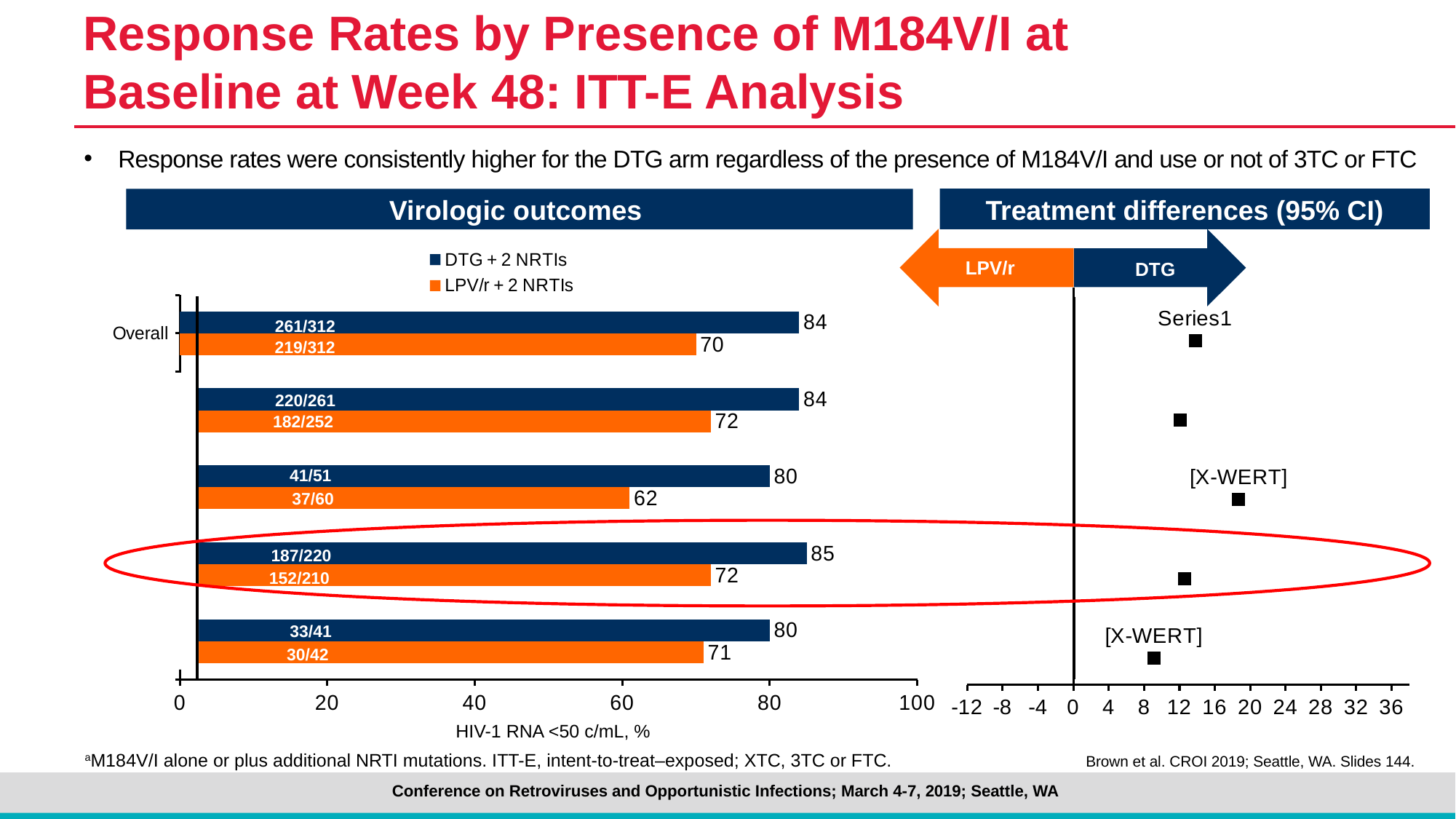
What is the x-axis label of the Virologic outcomes chart? HIV-1 RNA <50 c/mL, % In the Virologic outcomes chart, what is the highest value shown for the DTG + 2 NRTIs series? 85 In the Virologic outcomes chart, what fraction is printed on the DTG + 2 NRTIs bar for the Overall group? 261/312 In the Virologic outcomes chart, what fraction is printed on the LPV/r + 2 NRTIs bar for the Overall group? 219/312 How many series does the legend of the Virologic outcomes chart list? 2 In the Virologic outcomes chart, which series has the larger value in the Overall group, DTG + 2 NRTIs or LPV/r + 2 NRTIs? DTG + 2 NRTIs In the Virologic outcomes chart, what is the difference between the DTG + 2 NRTIs and LPV/r + 2 NRTIs values in the Overall group? 14 In the Virologic outcomes chart, what is the lowest value shown for the LPV/r + 2 NRTIs series? 62 In the Virologic outcomes chart, what is the value for DTG + 2 NRTIs in the Overall group? 84 In the Virologic outcomes chart, what is the value for LPV/r + 2 NRTIs in the Overall group? 70 What kind of chart is the Virologic outcomes chart? Bar chart How many groups of bars are shown in the Virologic outcomes chart? 5